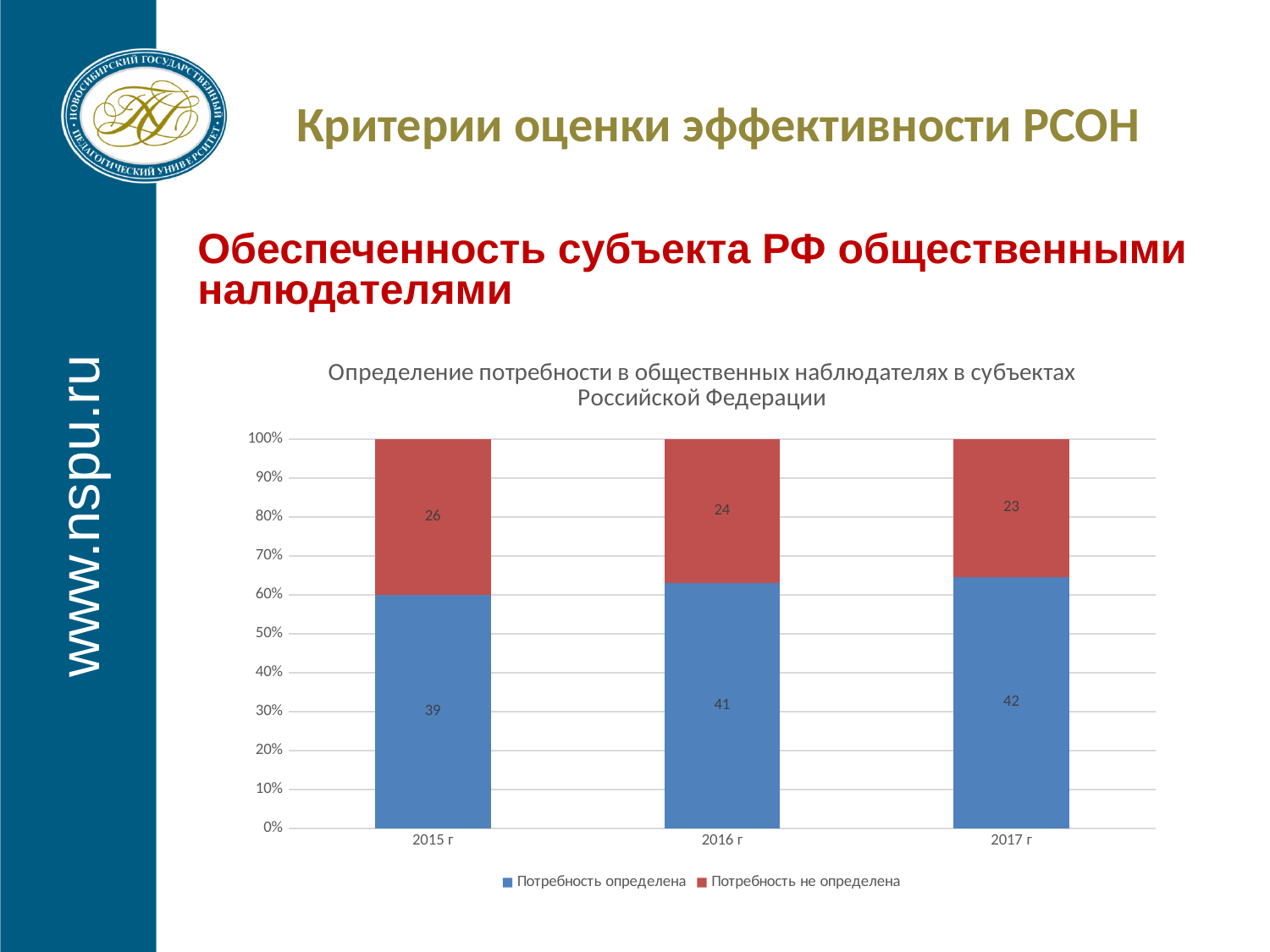
How many series does the legend list? 2 What is the total of the stacked bar for 2016 г? 65 What is the value for "Потребность определена" in 2015 г? 39 In which year is the value for "Потребность не определена" lowest? 2017 г What is the value for "Потребность не определена" in 2016 г? 24 What is the difference between the "Потребность определена" values for 2017 г and 2015 г? 3 In which year is the value for "Потребность определена" highest? 2017 г Does the value for "Потребность определена" rise or fall from 2015 г to 2017 г? Rise How many years are shown on the x axis? 3 What is the value for "Потребность не определена" in 2017 г? 23 Which is larger: "Потребность не определена" in 2015 г or in 2016 г? 2015 г What kind of chart is shown on the slide? Stacked bar chart